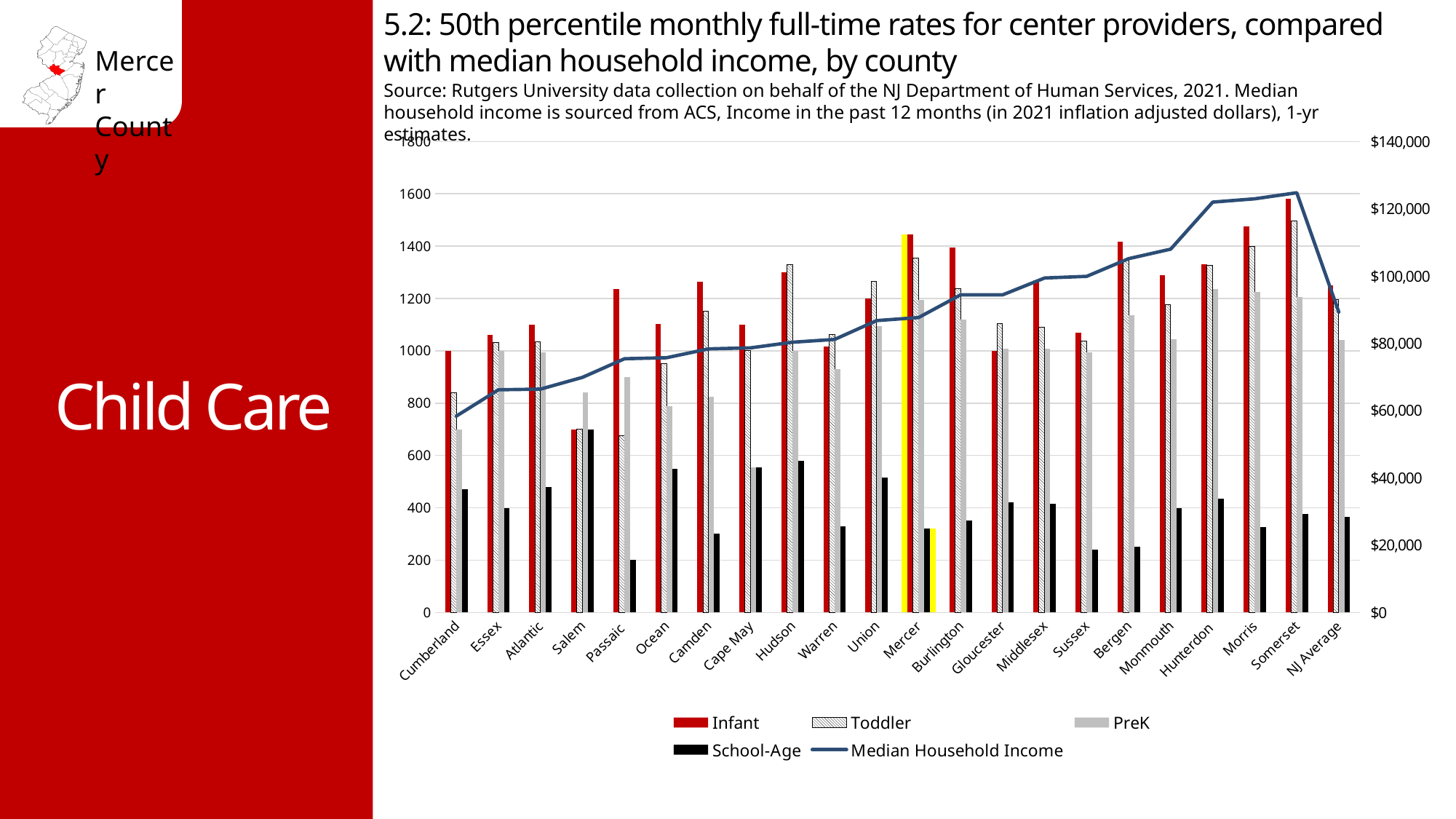
Which is larger, the Infant rate for Somerset or the Infant rate for Cumberland? Somerset Does the Median Household Income line generally rise or fall from Cumberland to Somerset? rise Is the Toddler rate for Hudson greater or less than 1200? greater Which county has the lowest Median Household Income on the line? Cumberland What kind of chart is shown on the slide? Bar chart with a line Which county's bars are highlighted in yellow on the chart? Mercer Is the School-Age rate for Salem greater or less than 600? greater Which county has the lowest Infant rate bar? Salem How many counties/categories are shown along the x axis of the chart? 22 Which county has the highest Infant rate bar? Somerset Is the Infant rate for Mercer greater or less than 1400? greater How many series does the chart legend list? 5